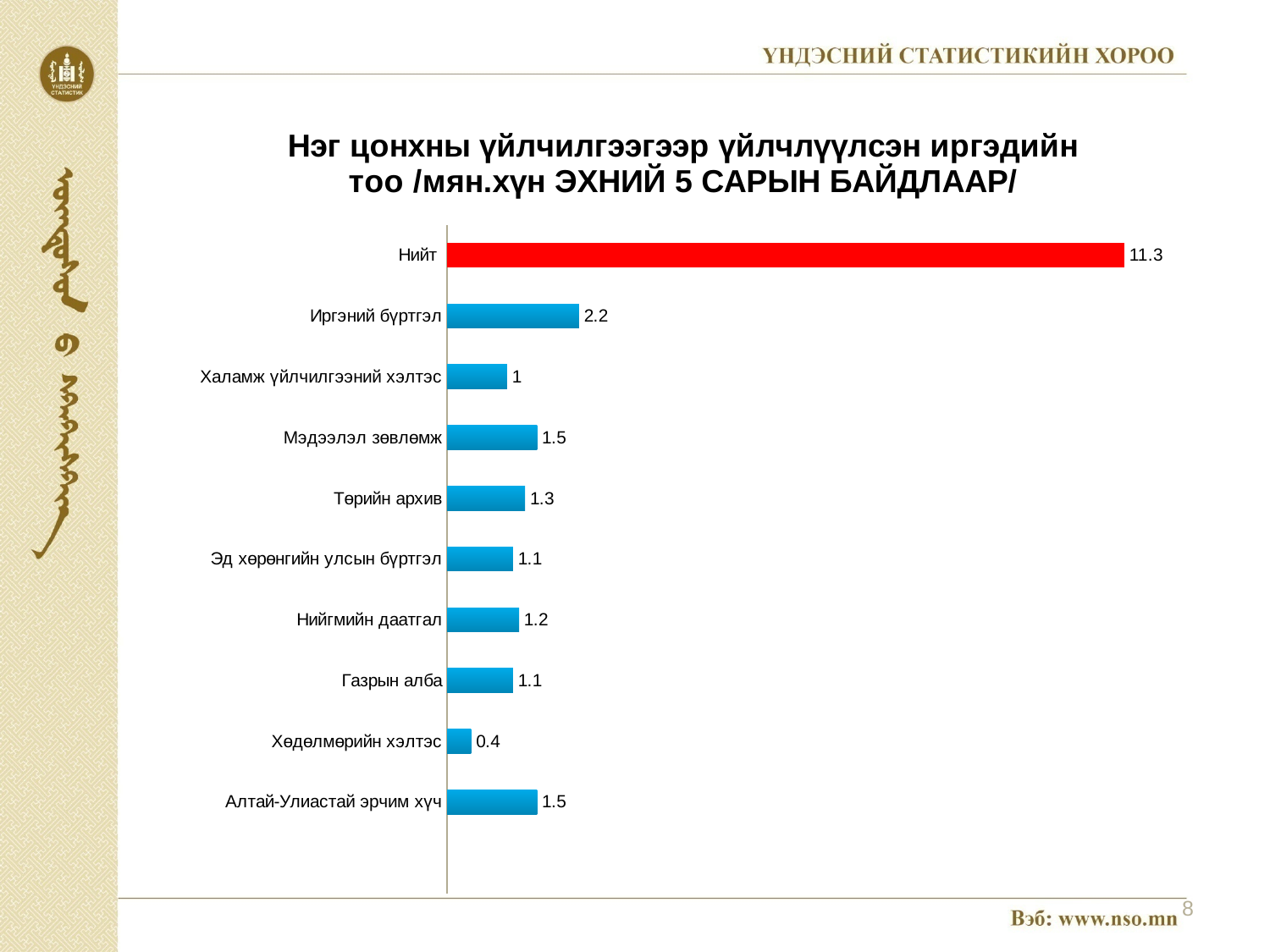
Which bar is coloured red rather than blue? Нийт How many categories are shown in the chart? 10 What kind of chart is shown on the slide? Bar chart Which is larger, the value for Мэдээлэл зөвлөмж or the value for Төрийн архив? Мэдээлэл зөвлөмж What is the value for Хөдөлмөрийн хэлтэс? 0.4 What is the value for Төрийн архив? 1.3 Which category has the highest value? Нийт What is the value for Иргэний бүртгэл? 2.2 What is the value for Нийт? 11.3 Which category has the lowest value? Хөдөлмөрийн хэлтэс What is the value for Нийгмийн даатгал? 1.2 What is the difference between the values for Иргэний бүртгэл and Халамж үйлчилгээний хэлтэс? 1.2